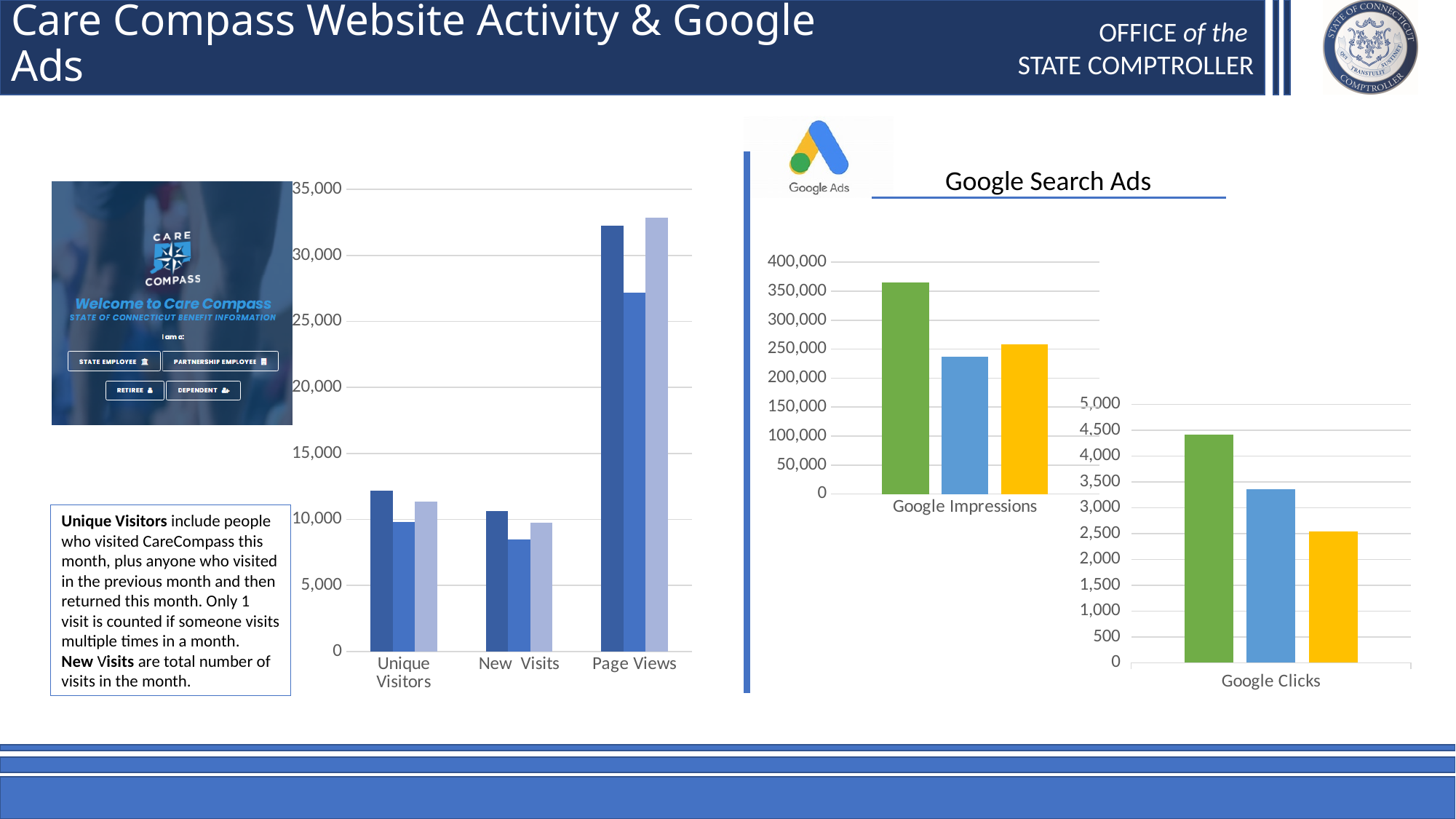
In the Google Impressions chart, is the value of the blue bar greater or less than 250,000? less What kind of chart is the website activity chart on the left of the slide? bar chart In the website activity chart on the left, is the value of the first (dark blue) bar for Page Views greater or less than 30,000? greater In the Google Impressions chart, which bar is the tallest? the green bar In the Google Impressions chart, is the value of the green bar greater or less than 300,000? greater How many categories are shown on the x axis of the website activity chart on the left? 3 What is the title shown above the Google Impressions and Google Clicks charts? Google Search Ads In the Google Clicks chart, which bar is the shortest? the yellow bar In the website activity chart on the left, which category has the highest values? Page Views